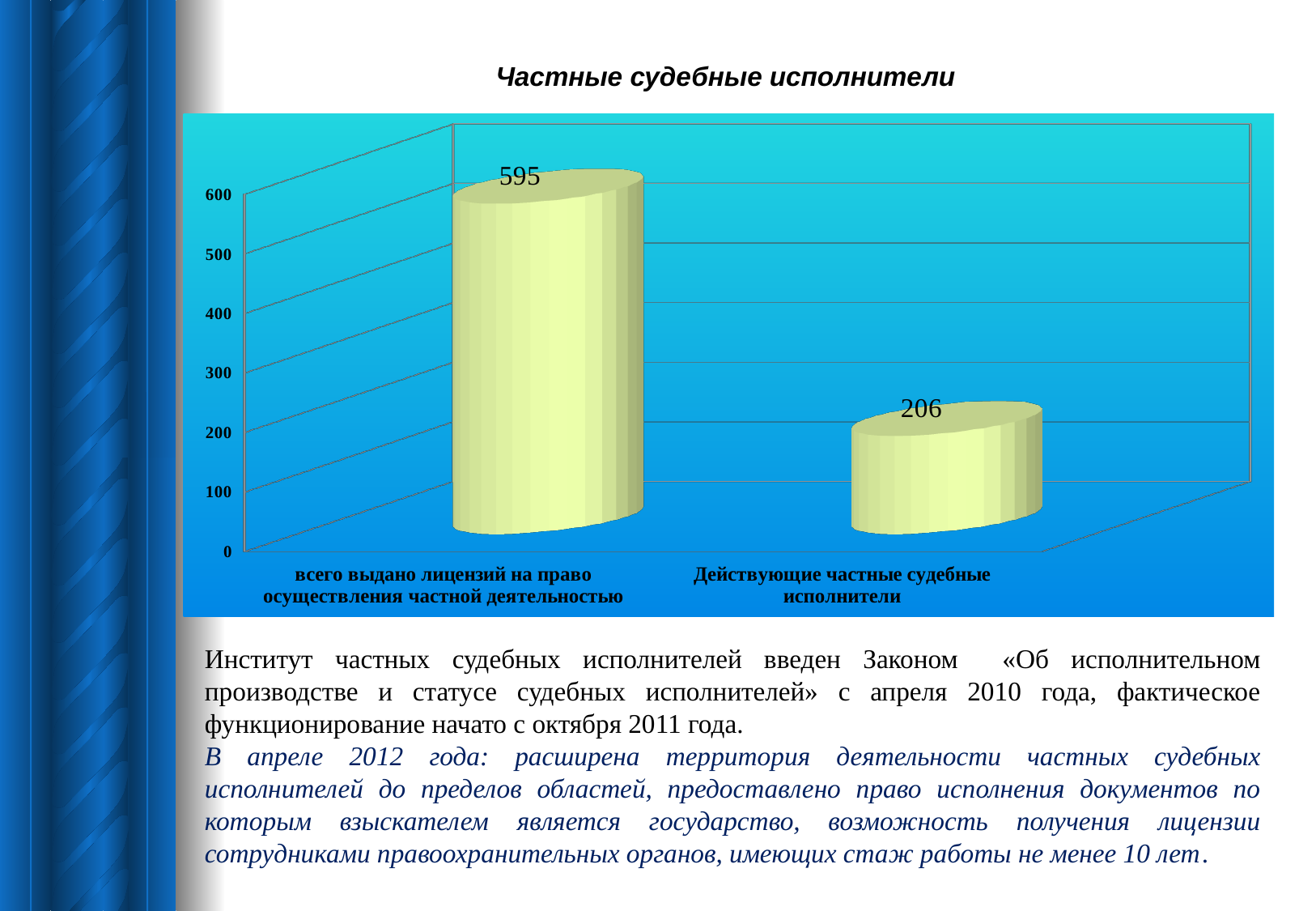
What is the value for "всего выдано лицензий на право осуществления частной деятельностью"? 595 What is the title of the chart? Частные судебные исполнители Which category has the lowest value? Действующие частные судебные исполнители What is the highest value labelled on the vertical axis? 600 How many categories are shown in the chart? 2 Is the value for "Действующие частные судебные исполнители" greater or less than 300? less Is the value for "всего выдано лицензий на право осуществления частной деятельностью" greater or less than 500? greater What kind of chart is shown on the slide? bar chart What is the difference between the value for "всего выдано лицензий на право осуществления частной деятельностью" and the value for "Действующие частные судебные исполнители"? 389 Which is larger: the value for "всего выдано лицензий на право осуществления частной деятельностью" or the value for "Действующие частные судебные исполнители"? всего выдано лицензий на право осуществления частной деятельностью Which category has the highest value? всего выдано лицензий на право осуществления частной деятельностью What is the value for "Действующие частные судебные исполнители"? 206